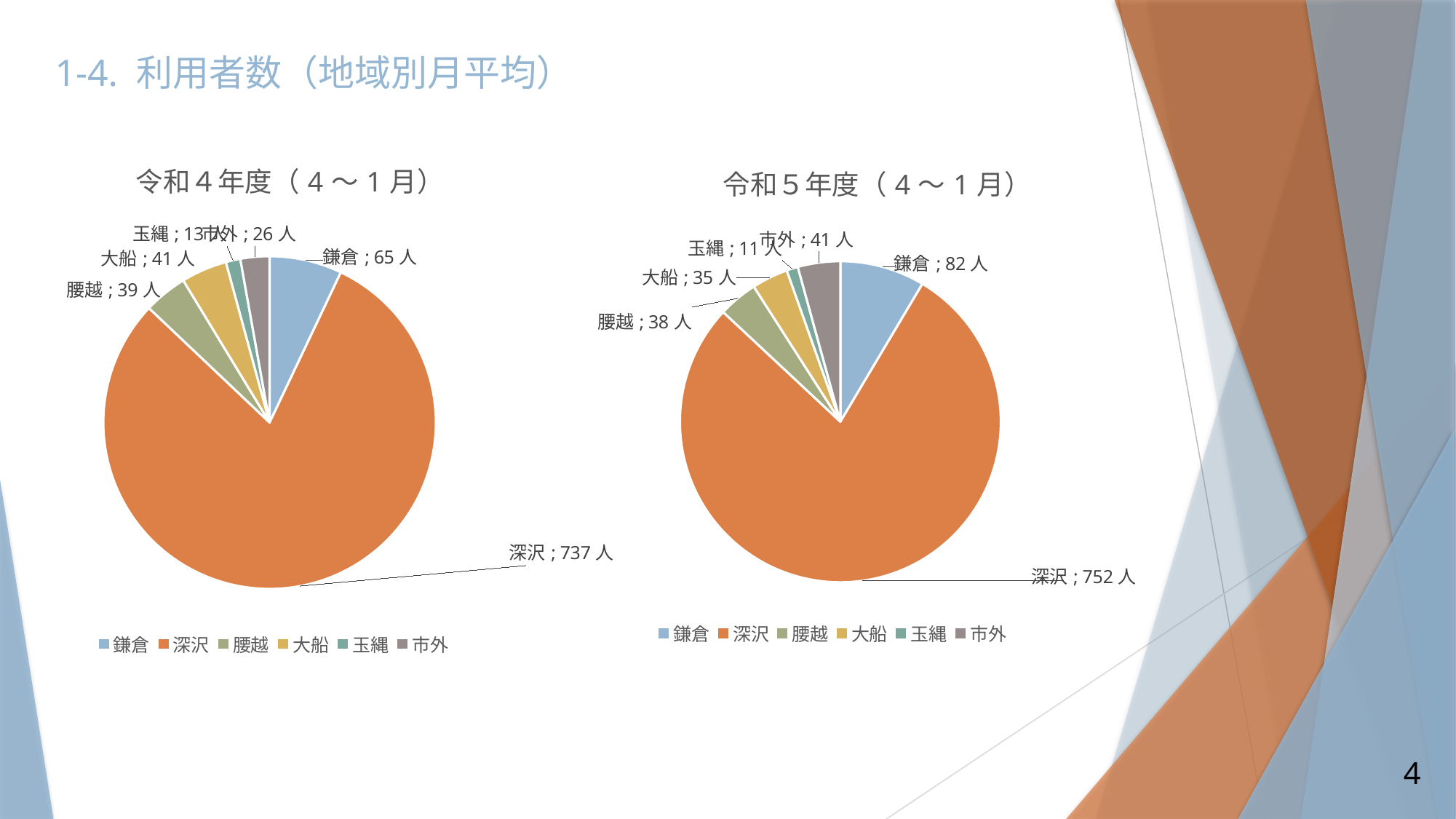
How many categories does the 令和４年度（４～１月） chart show? 6 What kind of chart is the 令和５年度（４～１月） chart? pie chart In the 令和５年度（４～１月） chart, what is the value for 市外? 41 人 In the 令和４年度（４～１月） chart, what is the difference between 鎌倉 and 腰越? 26 人 In the 令和５年度（４～１月） chart, what share of the total does 深沢 represent? 78.4% In the 令和５年度（４～１月） chart, what is the value for 鎌倉? 82 人 In the 令和５年度（４～１月） chart, what is the difference between 深沢 and 鎌倉? 670 人 In the 令和５年度（４～１月） chart, which category has the smallest value? 玉縄 What is the title of the chart on the left? 令和４年度（４～１月） In the 令和４年度（４～１月） chart, which category has the largest value? 深沢 In the 令和４年度（４～１月） chart, what is the value for 深沢? 737 人 In the 令和５年度（４～１月） chart, which is larger, 腰越 or 大船? 腰越